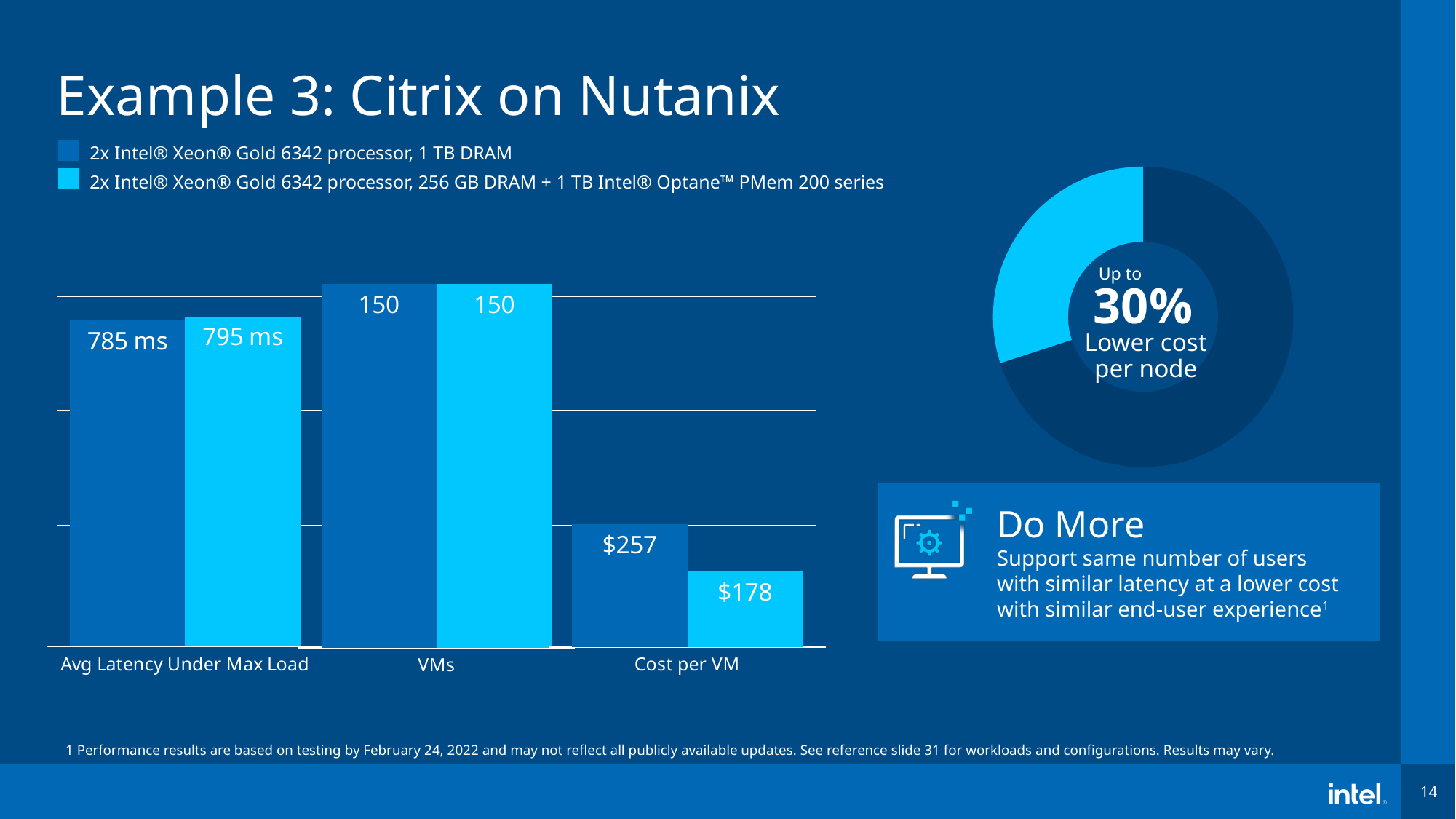
In the bar chart, which configuration has the higher Cost per VM? 2x Intel Xeon Gold 6342 processor, 1 TB DRAM How many categories are shown on the x axis of the bar chart? 3 In the bar chart, what is the Avg Latency Under Max Load for the 1 TB DRAM configuration? 785 ms In the bar chart, what is the Avg Latency Under Max Load for the 256 GB DRAM + 1 TB Intel Optane PMem 200 series configuration? 795 ms In the bar chart, how many VMs does each configuration support? 150 In the bar chart, what is the difference in Avg Latency Under Max Load between the two configurations? 10 ms In the donut chart on the right, what percentage lower cost per node is shown? 30% In the bar chart, what is the Cost per VM for the 256 GB DRAM + 1 TB Intel Optane PMem 200 series configuration? $178 In the bar chart, what is the difference in Cost per VM between the 1 TB DRAM configuration and the Optane PMem configuration? $79 What kind of chart is the chart on the left of the slide? Bar chart How many series does the legend of the bar chart list? 2 In the bar chart, what is the Cost per VM for the 1 TB DRAM configuration? $257